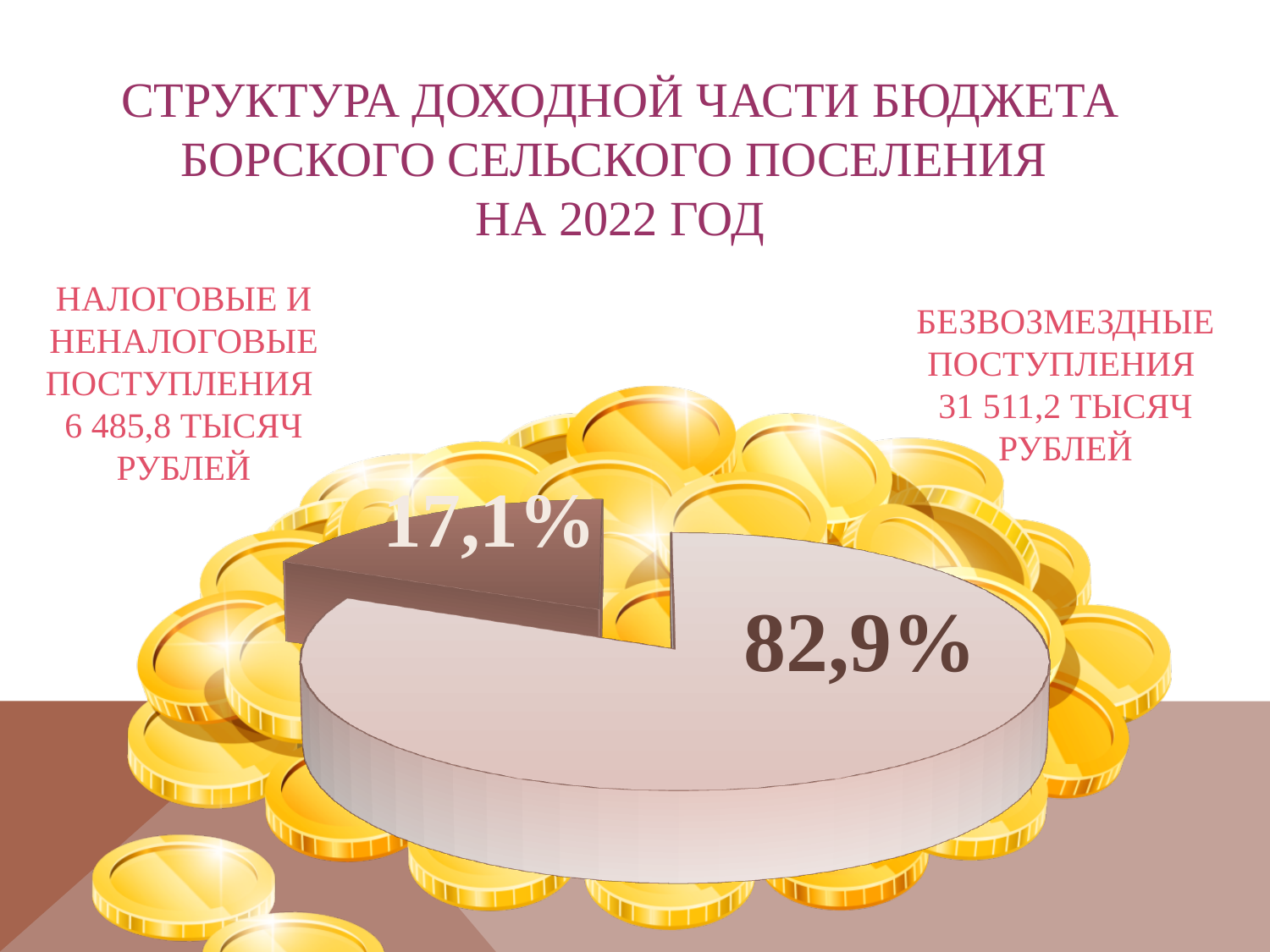
What is the difference in percentage points between the 82,9% slice and the 17,1% slice? 65,8 percentage points How many slices does the pie chart have? 2 Which category has the smallest share of the pie? Налоговые и неналоговые поступления Which is larger: the share for «Безвозмездные поступления» or the share for «Налоговые и неналоговые поступления»? Безвозмездные поступления What kind of chart is shown on the slide? Pie chart Which category has the largest share of the pie? Безвозмездные поступления What is the amount shown for «Налоговые и неналоговые поступления»? 6 485,8 тысяч рублей What is the difference between the amounts for «Безвозмездные поступления» and «Налоговые и неналоговые поступления»? 25 025,4 тысяч рублей What share of the pie is labelled for «Безвозмездные поступления»? 82,9% What is the title of the slide containing the pie chart? Структура доходной части бюджета Борского сельского поселения на 2022 год What share of the pie is labelled for «Налоговые и неналоговые поступления»? 17,1% What is the amount shown for «Безвозмездные поступления»? 31 511,2 тысяч рублей